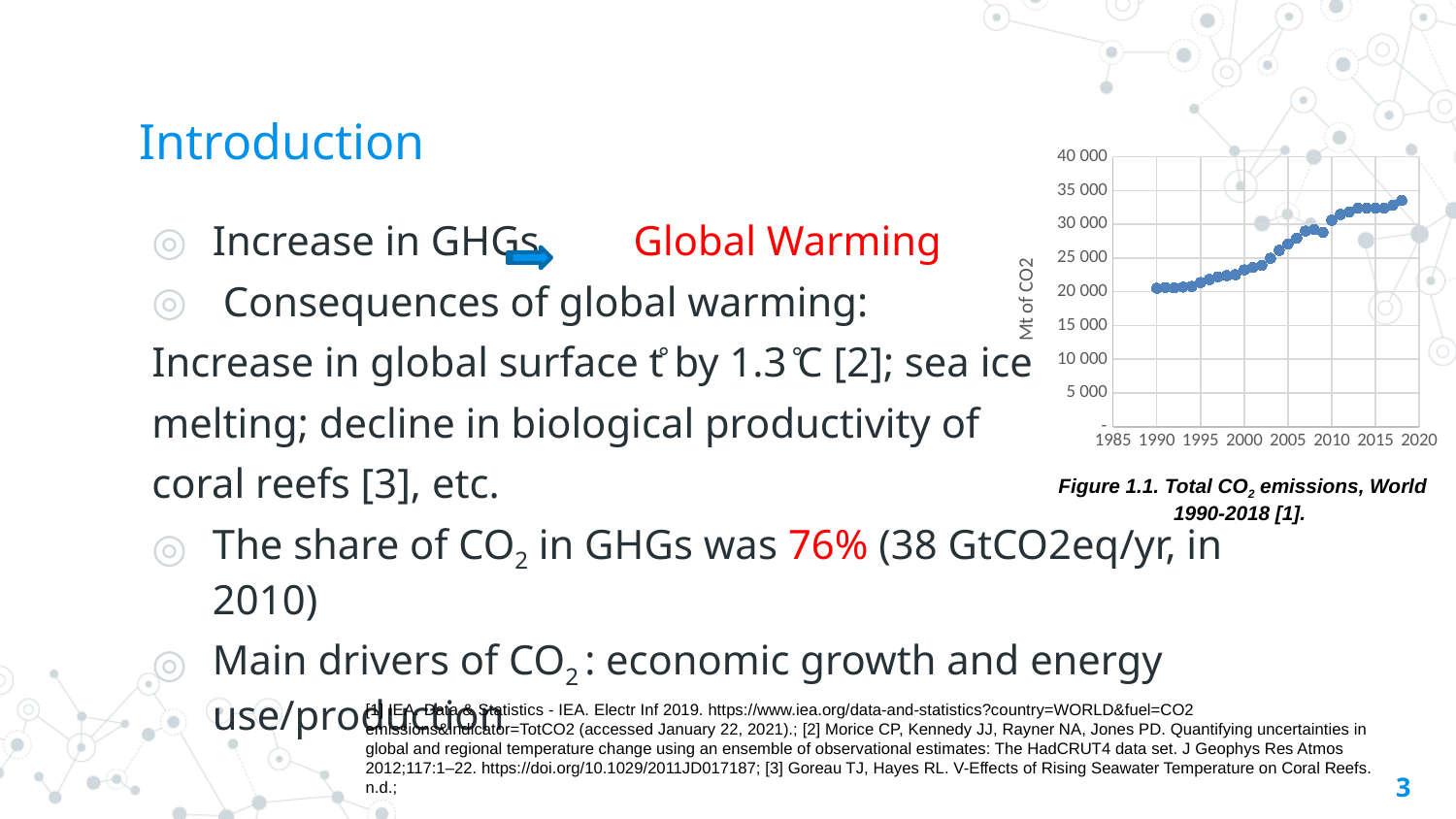
Is the value for 2005 greater or less than 25 000? greater Which is larger, the value for 2000 or the value for 2018? 2018 Is the value for 2018 greater or less than 30 000? greater Which is larger, the value for 1990 or the value for 2010? 2010 What is the label on the y axis of the chart? Mt of CO2 Is the value for 2015 greater or less than 35 000? less According to the caption, what does the chart show? Total CO2 emissions, World 1990-2018 Do the values in the chart generally rise or fall from 1990 to 2018? rise What kind of chart is shown on the slide? scatter chart Which year has the highest value in the chart? 2018